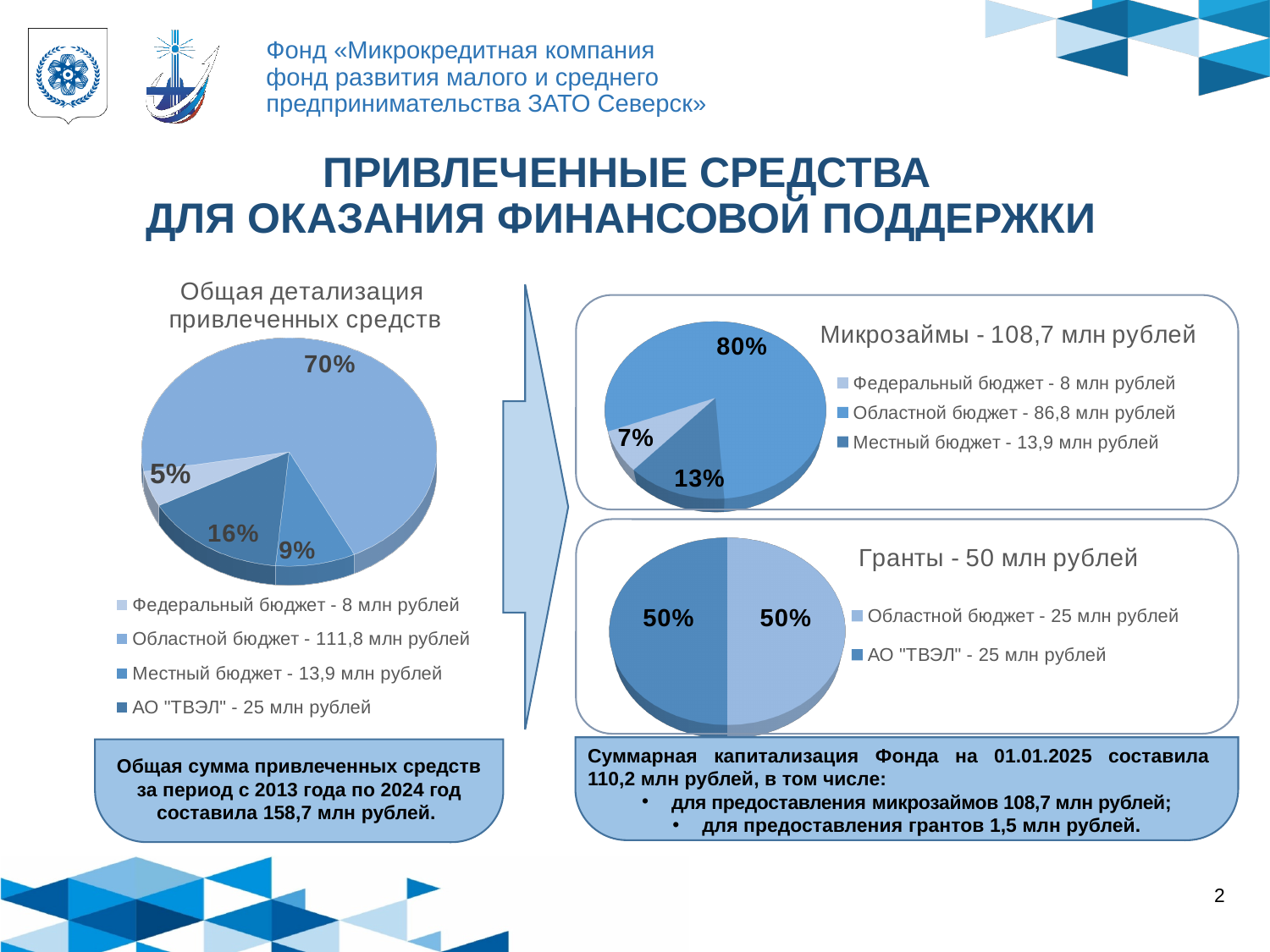
In the chart titled "Микрозаймы - 108,7 млн рублей", what is the difference in percentage points between the 13% slice and the 7% slice? 6 percentage points How many entries does the legend of the chart titled "Общая детализация привлеченных средств" list? 4 How many slices does the chart titled "Общая детализация привлеченных средств" have? 4 What kind of chart is the chart titled "Общая детализация привлеченных средств"? pie chart In the chart titled "Гранты - 50 млн рублей", what share does each of the two slices have? 50% In the chart titled "Микрозаймы - 108,7 млн рублей", what is the share of the largest slice? 80% In the chart titled "Общая детализация привлеченных средств", what amount does the legend give for "Областной бюджет"? 111,8 млн рублей In the chart titled "Общая детализация привлеченных средств", what is the share of the smallest slice? 5% In the chart titled "Общая детализация привлеченных средств", what share of the pie is labelled for the largest slice? 70% How many entries does the legend of the chart titled "Гранты - 50 млн рублей" list? 2 In the chart titled "Общая детализация привлеченных средств", what amount does the legend give for "АО "ТВЭЛ""? 25 млн рублей In the chart titled "Микрозаймы - 108,7 млн рублей", what amount does the legend give for "Местный бюджет"? 13,9 млн рублей